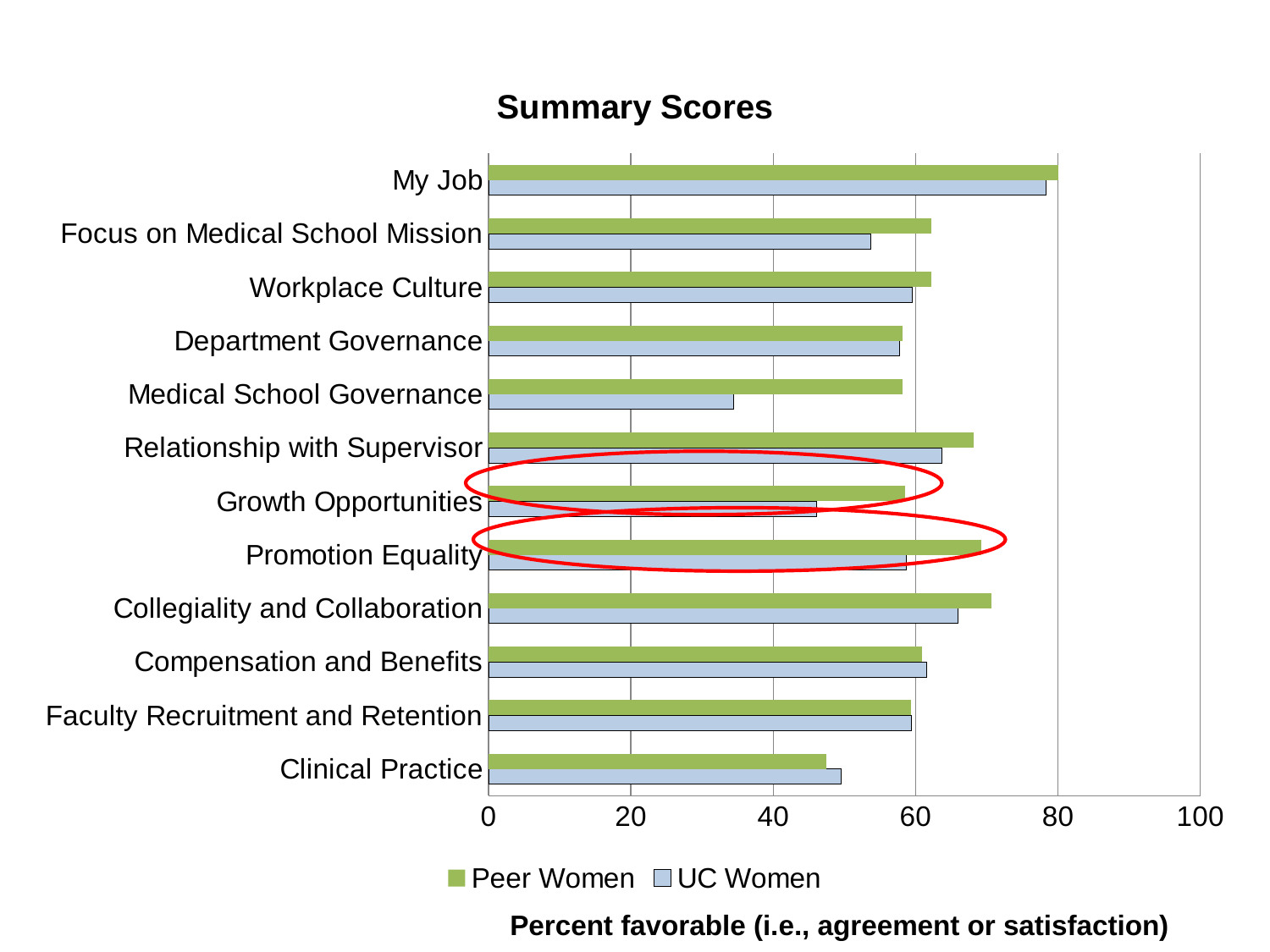
What is the title of the chart? Summary Scores Is the value for UC Women in Growth Opportunities greater or less than 60? less Which category has the lowest value for UC Women? Medical School Governance For Promotion Equality, which series has the larger value, Peer Women or UC Women? Peer Women What kind of chart is shown on the slide? bar chart Is the value for UC Women in Medical School Governance greater or less than 40? less For Medical School Governance, which series has the larger value, Peer Women or UC Women? Peer Women How many series does the legend list? 2 Which category has the lowest value for Peer Women? Clinical Practice How many categories are plotted on the chart? 12 Is the value for Peer Women in My Job greater or less than 60? greater Which category has the highest value for UC Women? My Job